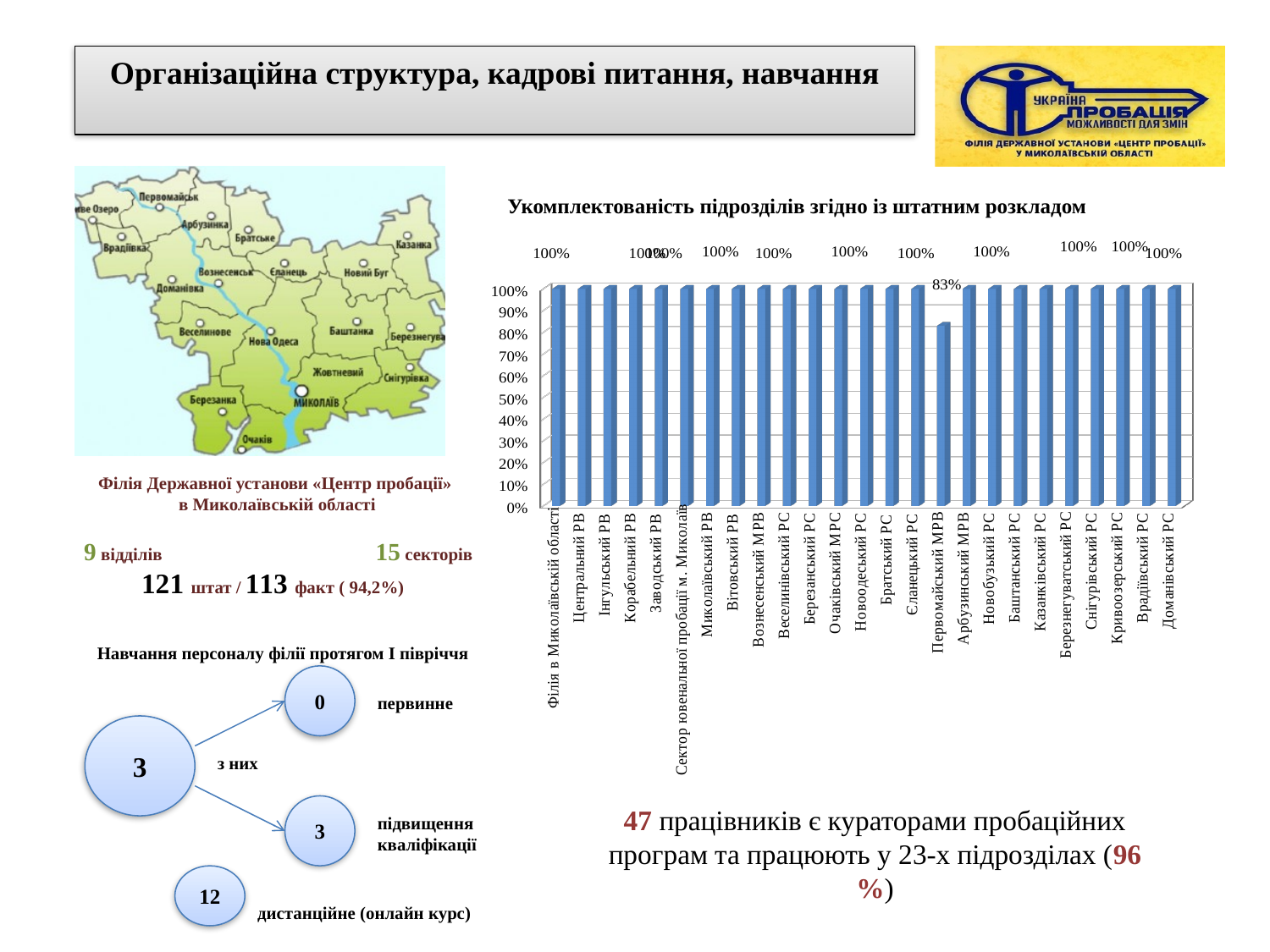
Which has the higher staffing level, Первомайський МРВ or Арбузинський МРВ? Арбузинський МРВ Is the value for Братський РС greater or less than 90%? greater How many units in the chart have a staffing level below 100%? 1 Is the value for Первомайський МРВ greater or less than 90%? less What is the staffing level shown for Первомайський МРВ? 83% What is the difference between the staffing level of Центральний РВ and that of Первомайський МРВ? 17% How many units (categories) are plotted in the chart? 25 What kind of chart is shown under the title "Укомплектованість підрозділів згідно із штатним розкладом"? bar chart Which unit has the lowest staffing level in the chart? Первомайський МРВ What is the staffing level shown for Центральний РВ? 100% What is the staffing level shown for Доманівський РС? 100% What is the title of the chart on the slide? Укомплектованість підрозділів згідно із штатним розкладом